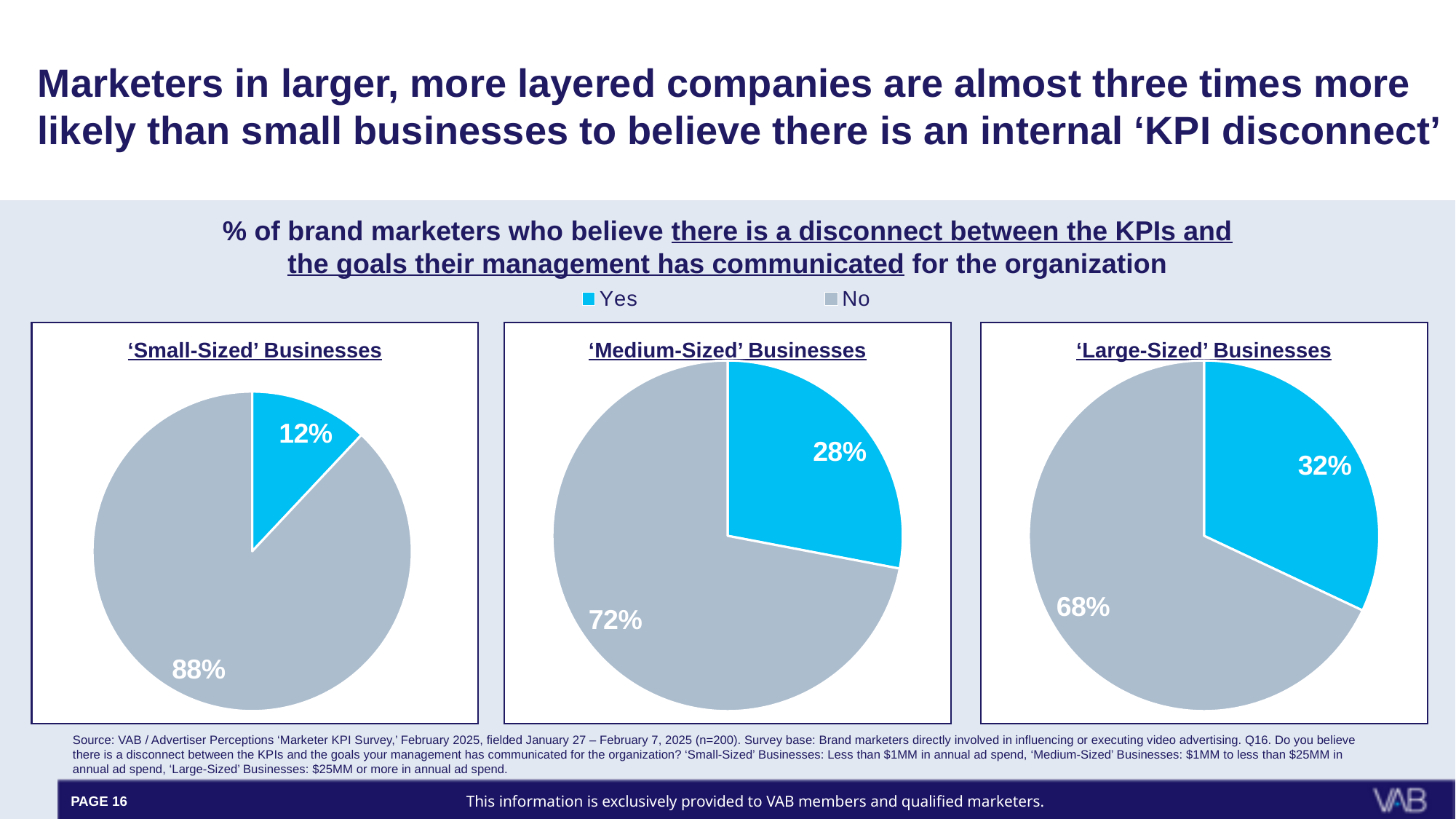
How many pie charts are shown on the slide? 3 In the 'Large-Sized' Businesses pie chart, what percentage answered Yes? 32% Across the three pie charts, which business size has the lowest Yes share? 'Small-Sized' Businesses How many series does the shared legend list? 2 In the 'Small-Sized' Businesses pie chart, what percentage answered No? 88% In the 'Small-Sized' Businesses pie chart, what percentage answered Yes? 12% Which colour represents the 'Yes' responses in the pie charts? Blue What type of chart is used for the 'Medium-Sized' Businesses data? Pie chart What is the difference between the Yes share in the 'Large-Sized' Businesses chart and the Yes share in the 'Small-Sized' Businesses chart? 20 percentage points In the 'Medium-Sized' Businesses pie chart, what percentage answered No? 72% Across the three pie charts, which business size has the highest Yes share? 'Large-Sized' Businesses Is the Yes share larger in the 'Medium-Sized' Businesses chart or the 'Large-Sized' Businesses chart? 'Large-Sized' Businesses